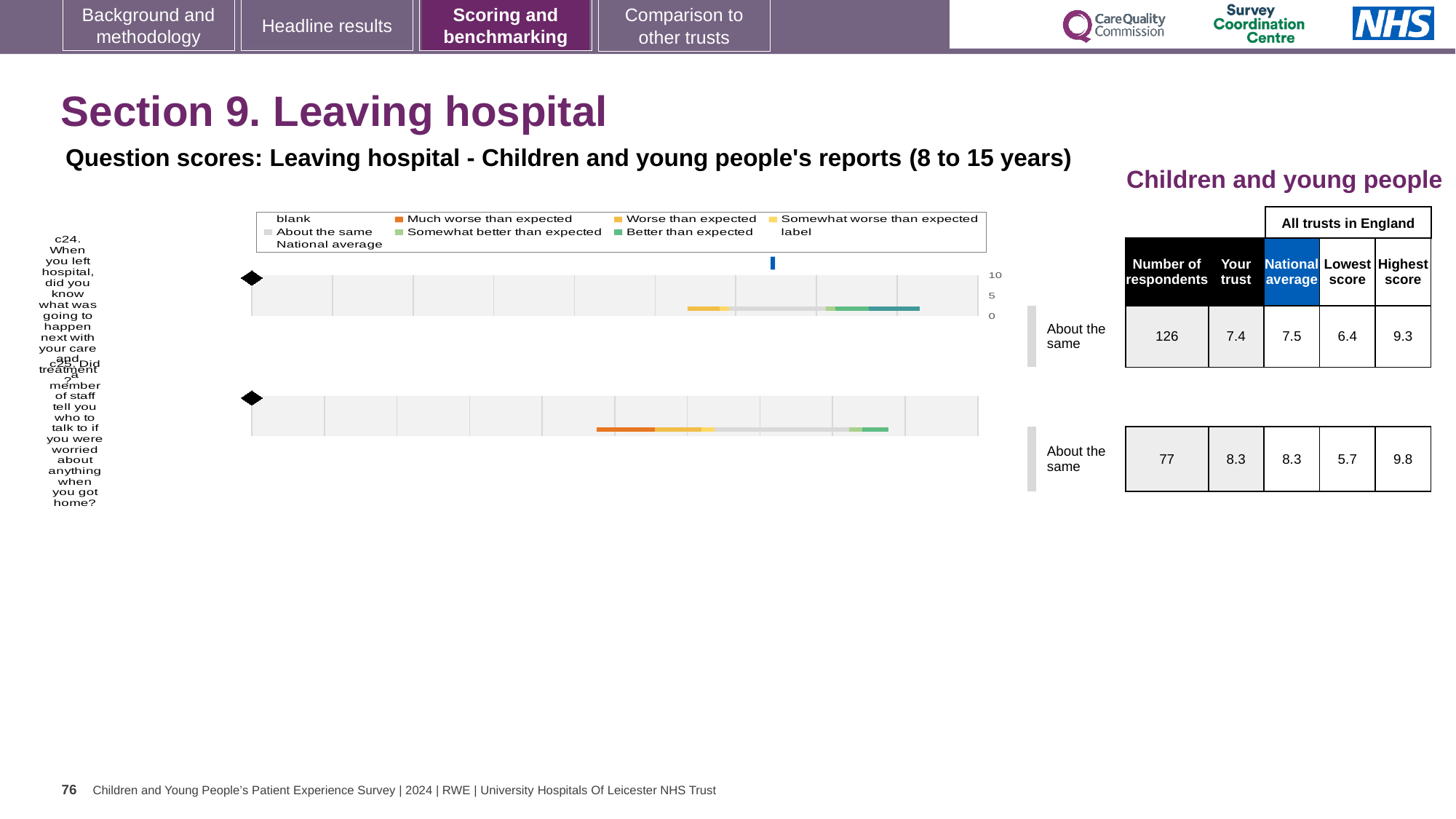
What is the national average score for question c24? 7.5 What is the difference between the highest and lowest trust scores for question c25? 4.1 What is the 'Your trust' score for question c24 (When you left hospital, did you know what was going to happen next with your care and treatment?)? 7.4 How many questions (chart rows) are plotted on the slide? 2 What is the highest score among all trusts in England for question c25? 9.8 How many respondents answered question c25 (Did a member of staff tell you who to talk to if you were worried about anything when you got home?)? 77 What is the difference in the number of respondents between question c24 and question c25? 49 What is the lowest score among all trusts in England for question c24? 6.4 What benchmark category is shown for the trust's score on question c25? About the same Which question has more respondents, c24 or c25? c24 What is the maximum value shown on the score axis of the charts? 10 What kind of chart is used to show the question scores for c24 and c25? Bar chart